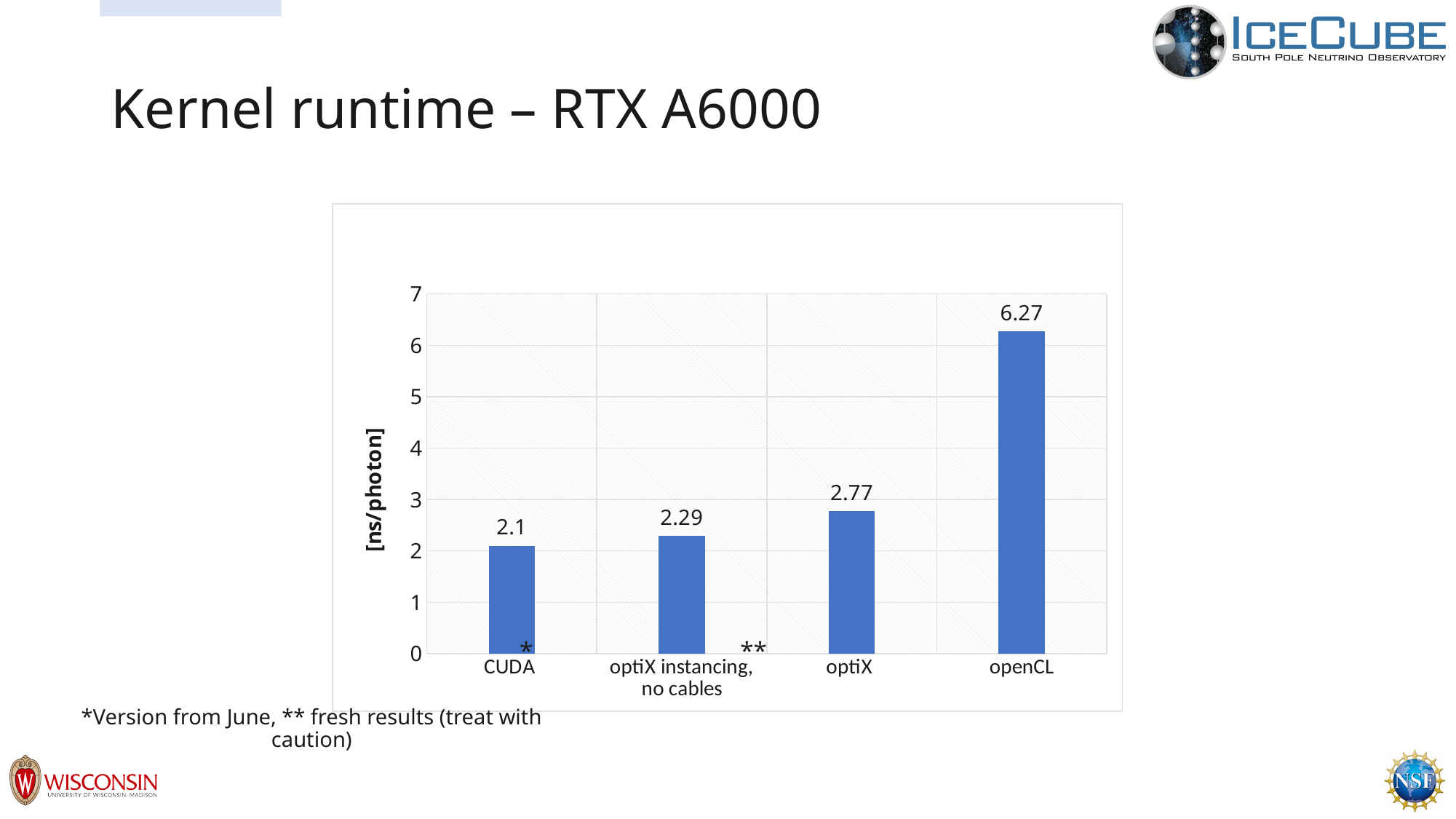
What is the kernel runtime value for openCL? 6.27 What is the label of the y axis? [ns/photon] What is the kernel runtime value for optiX? 2.77 What is the difference between the optiX and optiX instancing, no cables values? 0.48 What is the difference between the openCL and CUDA values? 4.17 What kind of chart is shown on the slide? bar chart Which category has the highest kernel runtime? openCL Which category has the lowest kernel runtime? CUDA Which is larger, the value for optiX or the value for CUDA? optiX What is the kernel runtime value for CUDA? 2.1 What is the kernel runtime value for optiX instancing, no cables? 2.29 How many categories are shown on the x axis? 4